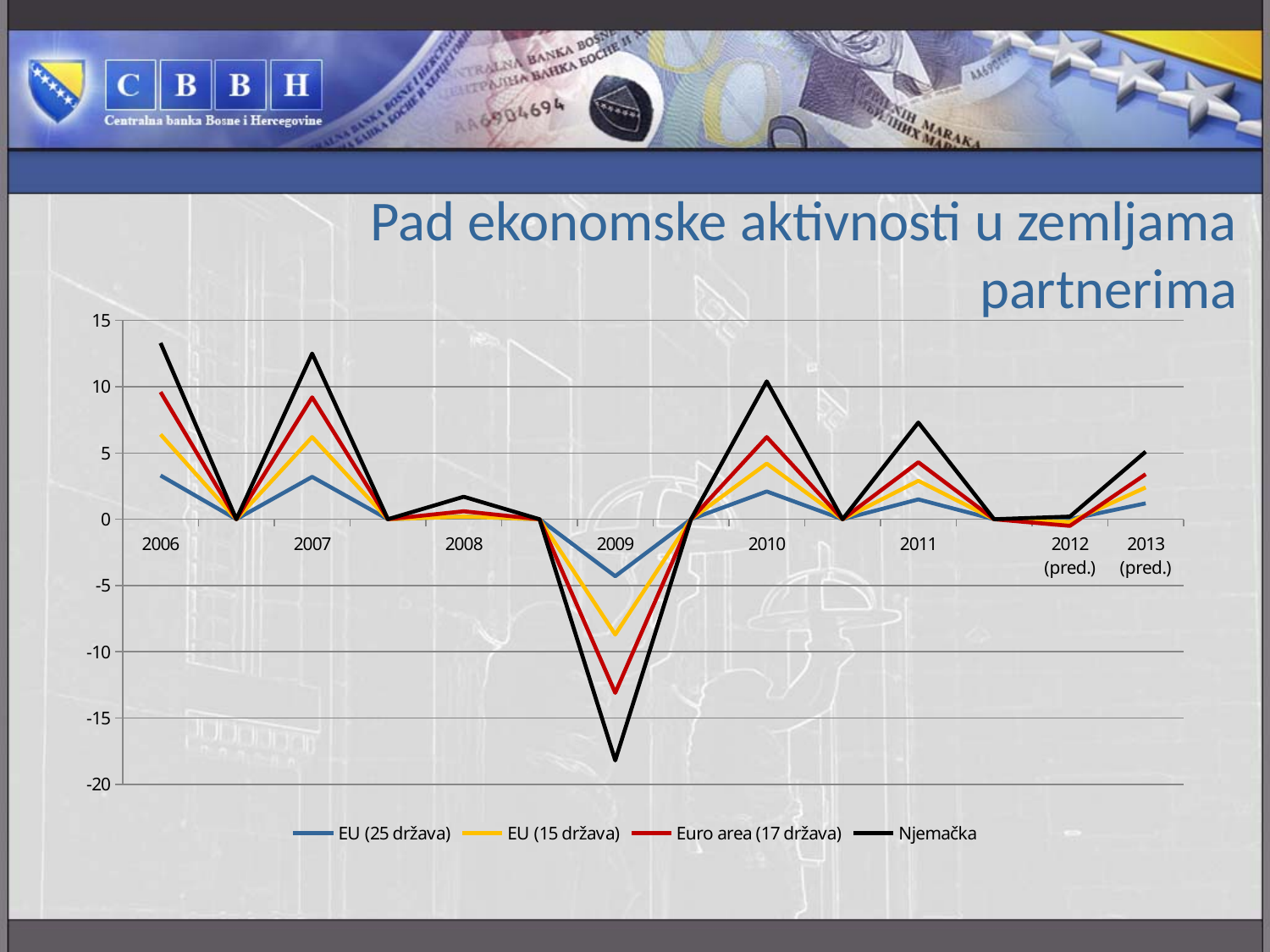
Which is lower in 2009, Njemačka or EU (25 država)? Njemačka How many years are labelled on the x axis? 8 Is the value for Euro area (17 država) in 2009 greater or less than -10? less How many series does the legend list? 4 Which series has the highest value in 2006? Njemačka What colour is the Njemačka line in the legend? black In which year does the Njemačka series reach its lowest value? 2009 Is the value for Njemačka in 2006 greater or less than 10? greater Which series has the lowest value in 2009? Njemačka What kind of chart is shown on the slide? line chart Is the value for EU (15 država) in 2009 greater or less than -5? less